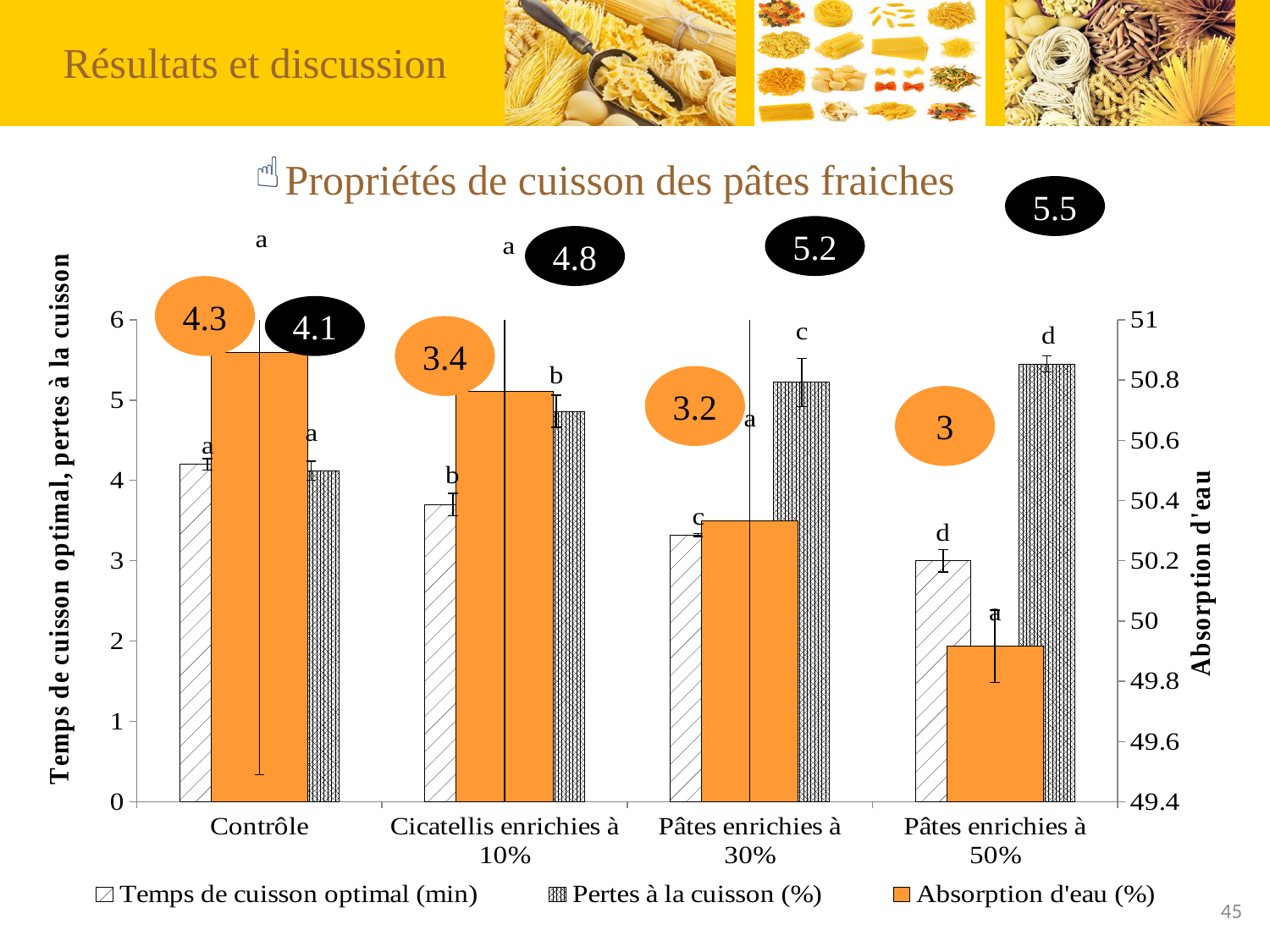
Is the Absorption d'eau (%) value for Contrôle greater or less than 50.6? greater Which category has the highest Pertes à la cuisson (%)? Pâtes enrichies à 50% What kind of chart is shown on the slide? bar chart Which category has the highest Temps de cuisson optimal (min)? Contrôle What is the title of the secondary (right) y axis? Absorption d'eau Which has the larger Absorption d'eau (%): Contrôle or Pâtes enrichies à 50%? Contrôle Do the values for Pertes à la cuisson (%) rise or fall from Contrôle to Pâtes enrichies à 50%? rise Do the values for Temps de cuisson optimal (min) rise or fall from Contrôle to Pâtes enrichies à 50%? fall Which category has the lowest Temps de cuisson optimal (min)? Pâtes enrichies à 50% How many categories are shown on the x axis? 4 According to the orange callout, what is the Temps de cuisson optimal value for Contrôle? 4.3 How many series does the legend list? 3